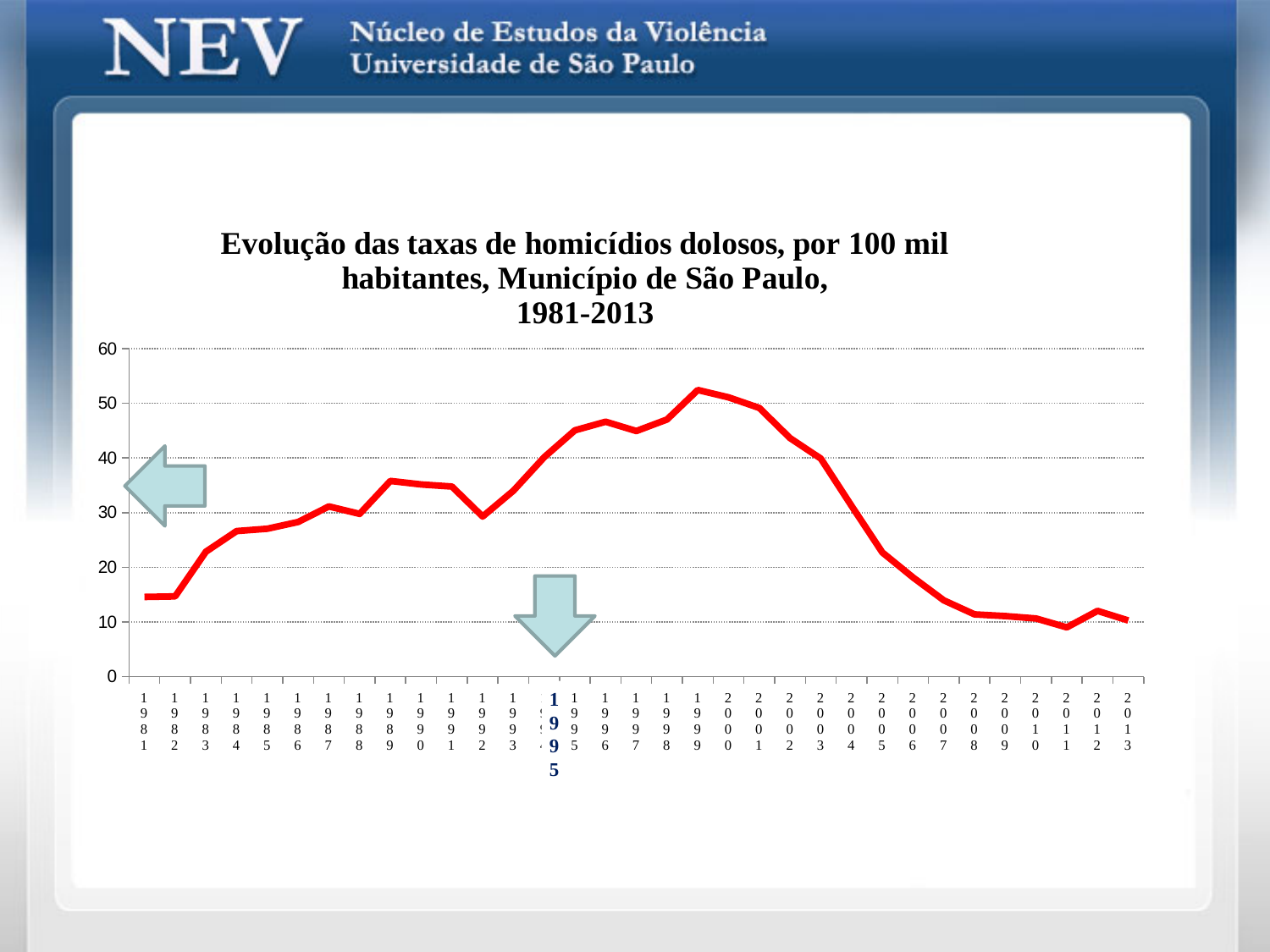
In which year is the homicide rate at its lowest? 2011 Is the value for 2008 greater or less than 20? less Is the value for 1999 greater or less than 50? greater Is the value for 1981 greater or less than 20? less How many years (data points) are plotted on the chart? 33 Does the homicide rate rise or fall between 1999 and 2013? fall In which year does the homicide rate reach its highest value? 1999 Which year has the higher homicide rate, 1989 or 1999? 1999 What colour is the plotted line? red What kind of chart is shown on the slide? line chart What is the title of the chart? Evolução das taxas de homicídios dolosos, por 100 mil habitantes, Município de São Paulo, 1981-2013